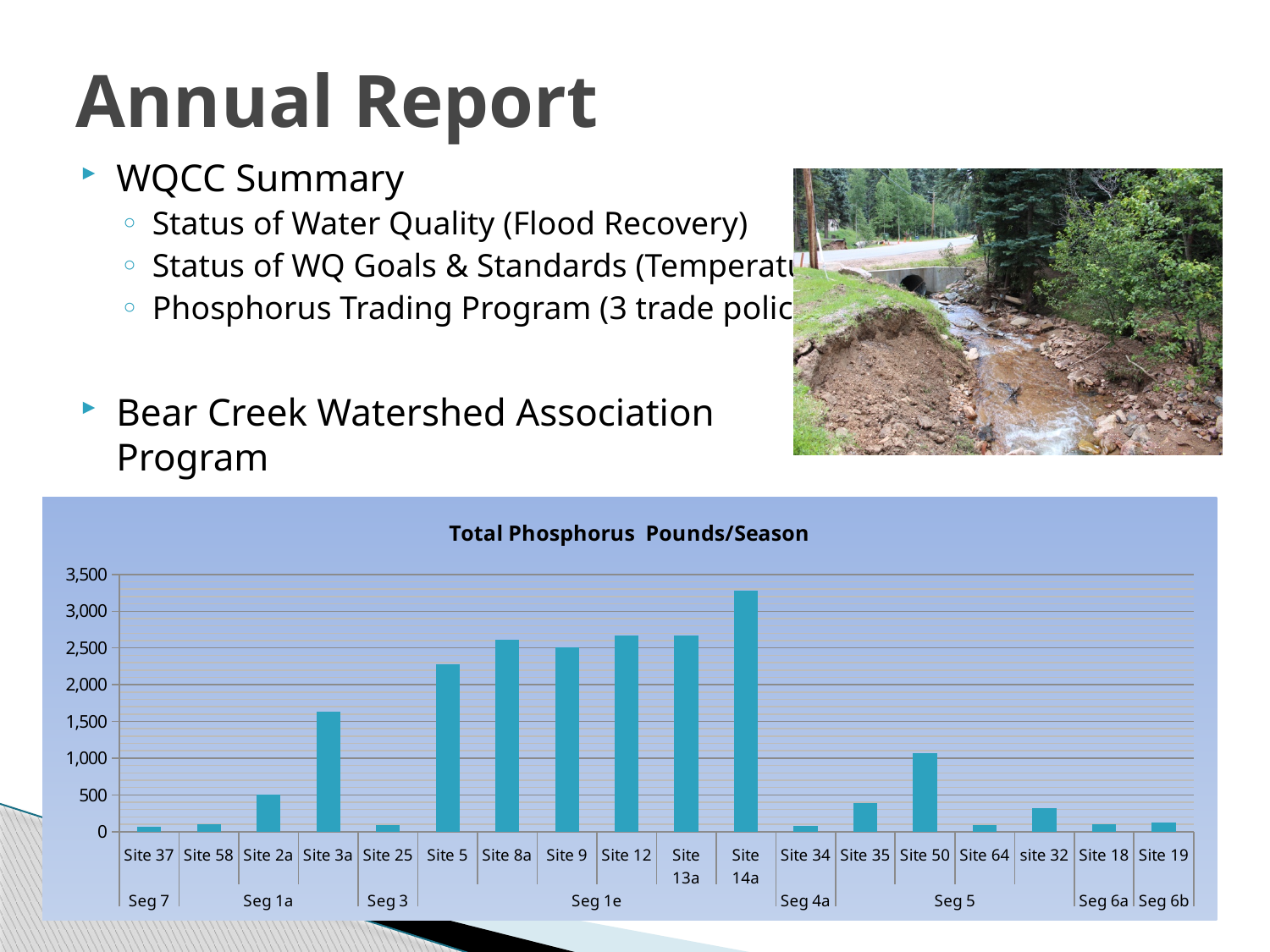
Is the value for Site 3a greater or less than 1,500? greater How many sites are plotted along the x axis of the chart? 18 Is the value for Site 14a greater or less than 3,000? greater Is the value for Site 50 greater or less than 1,500? less What is the title of the chart on the slide? Total Phosphorus Pounds/Season What kind of chart is shown on the slide? bar chart Which has the larger value, Site 5 or Site 8a? Site 8a How many segment groups (Seg labels) are shown along the x axis of the chart? 8 Which site has the highest total phosphorus value in the chart? Site 14a Which has the larger value, Site 3a or Site 50? Site 3a